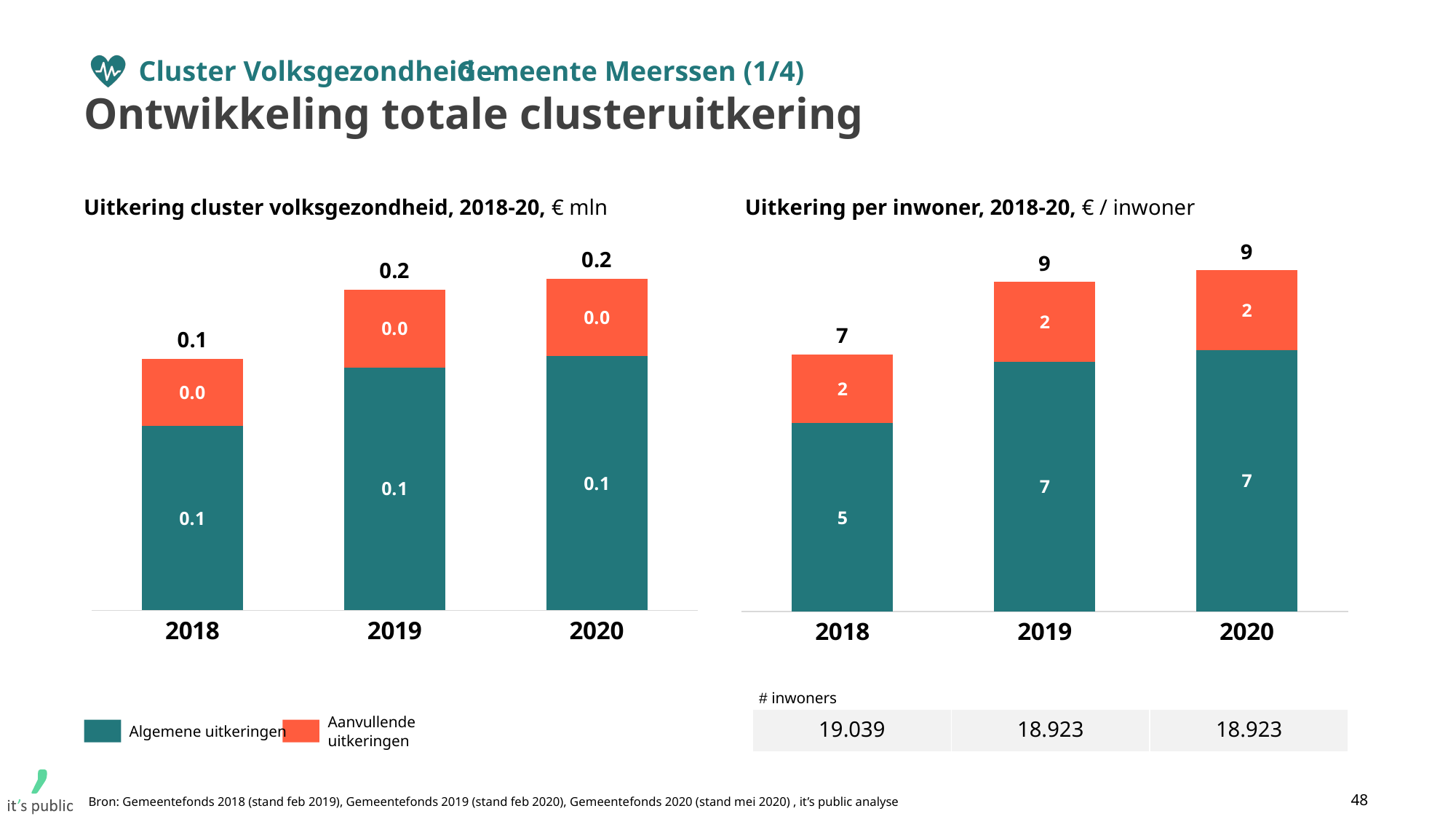
In the 'Uitkering per inwoner' chart, what is the value of Aanvullende uitkeringen for 2020? 2 How many series does the legend list for the charts on this slide? 2 In the 'Uitkering per inwoner' chart, what is the total of the stacked bar for 2019? 9 How many years are shown on the x axis of the 'Uitkering cluster volksgezondheid' chart? 3 In the 'Uitkering cluster volksgezondheid' chart, what is the value of Algemene uitkeringen for 2019? 0.1 In the 'Uitkering cluster volksgezondheid' chart, what is the total of the stacked bar for 2018? 0.1 In the 'Uitkering per inwoner' chart, what is the value of Algemene uitkeringen for 2018? 5 What kind of chart is the 'Uitkering per inwoner' chart? Stacked bar chart In the 'Uitkering per inwoner' chart, is the total for 2020 larger or smaller than the total for 2018? larger In the 'Uitkering per inwoner' chart, do the totals rise or fall from 2018 to 2020? rise In the 'Uitkering per inwoner' chart, which year has the lowest total? 2018 In the 'Uitkering per inwoner' chart, what is the difference between the Algemene uitkeringen values for 2019 and 2018? 2